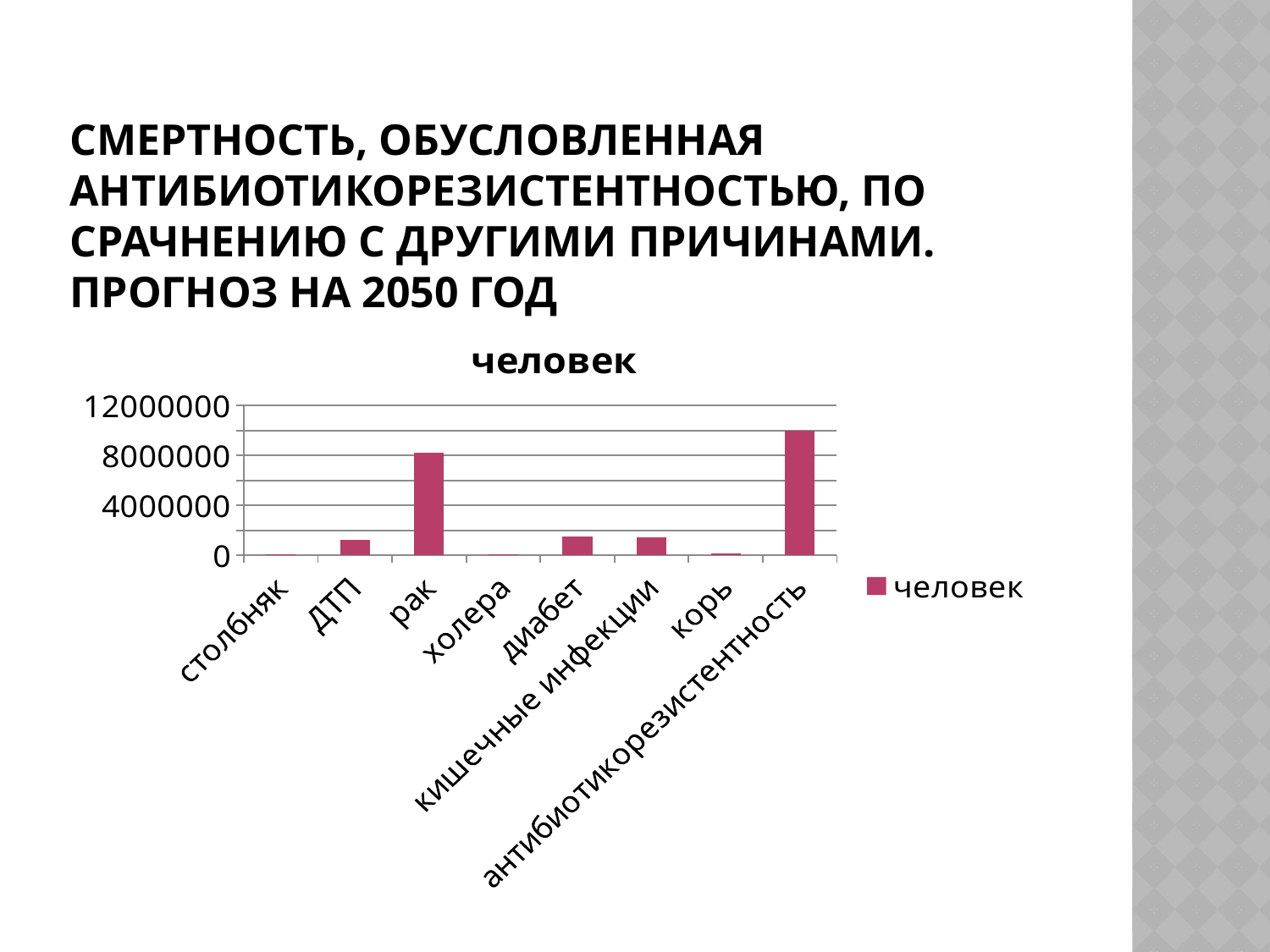
Which has the larger value, антибиотикорезистентность or рак? антибиотикорезистентность How many categories are shown on the x axis of the chart? 8 Which has the larger value, рак or ДТП? рак What is the title of the chart? человек Is the value for ДТП greater or less than 4000000? less What kind of chart is shown on the slide? bar chart Is the value for антибиотикорезистентность greater or less than 8000000? greater How many series does the chart's legend list? 1 Is the value for диабет greater or less than 4000000? less Which category has the highest value in the chart? антибиотикорезистентность